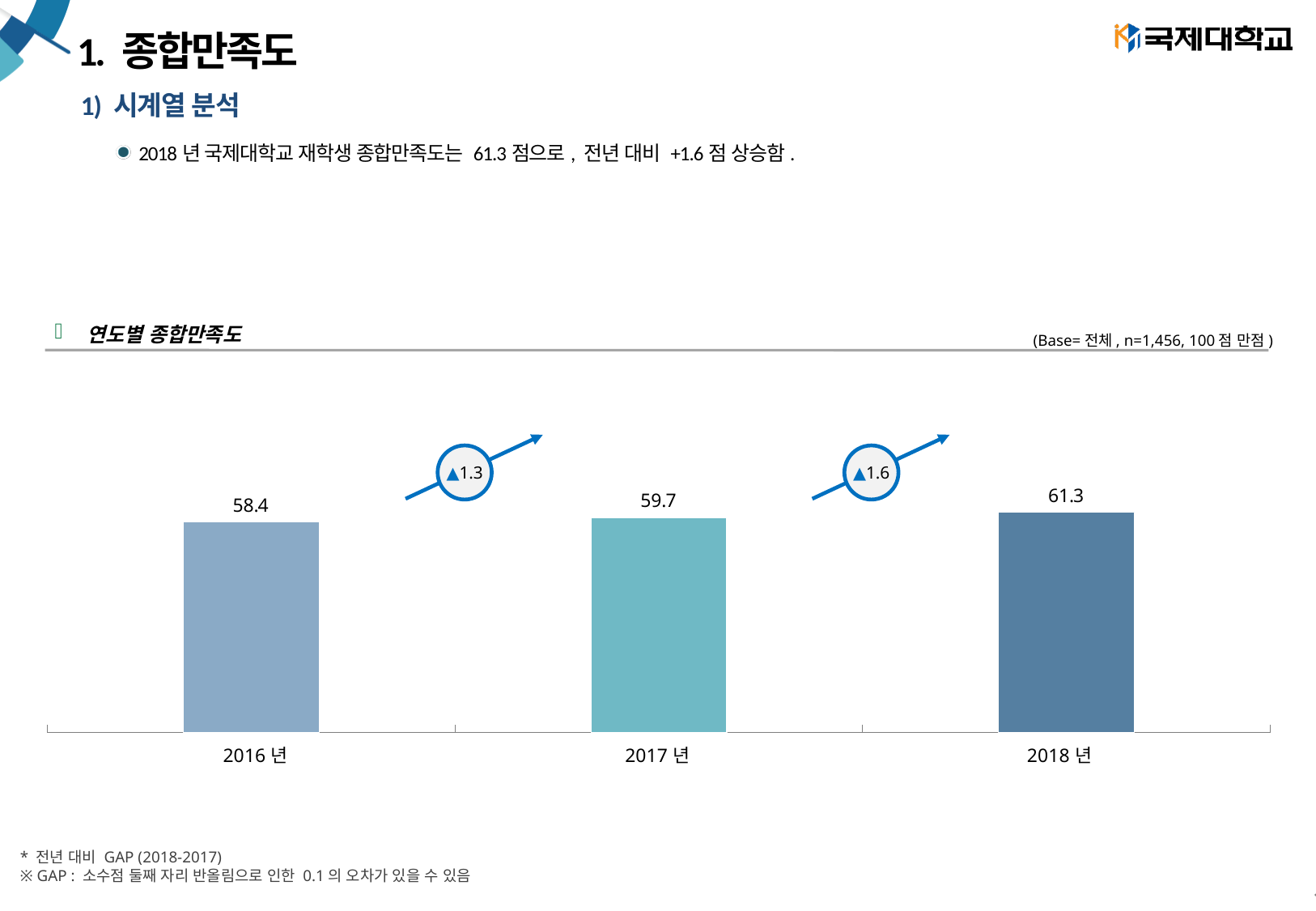
What is the difference between the 2017년 and 2016년 values in the 연도별 종합만족도 chart? 1.3 What is the difference between the 2018년 and 2017년 values in the 연도별 종합만족도 chart? 1.6 Do the values in the 연도별 종합만족도 chart rise or fall from 2016년 to 2018년? Rise What kind of chart is the 연도별 종합만족도 chart? Bar chart Which is larger in the 연도별 종합만족도 chart, the value for 2016년 or 2018년? 2018년 What is the value for 2017년 in the 연도별 종합만족도 chart? 59.7 How many years are shown in the 연도별 종합만족도 chart? 3 Which year has the lowest value in the 연도별 종합만족도 chart? 2016년 Which year has the highest value in the 연도별 종합만족도 chart? 2018년 What is the sample size (n) stated in the base note of the 연도별 종합만족도 chart? 1,456 What is the value for 2018년 in the 연도별 종합만족도 chart? 61.3 What is the value for 2016년 in the 연도별 종합만족도 chart? 58.4